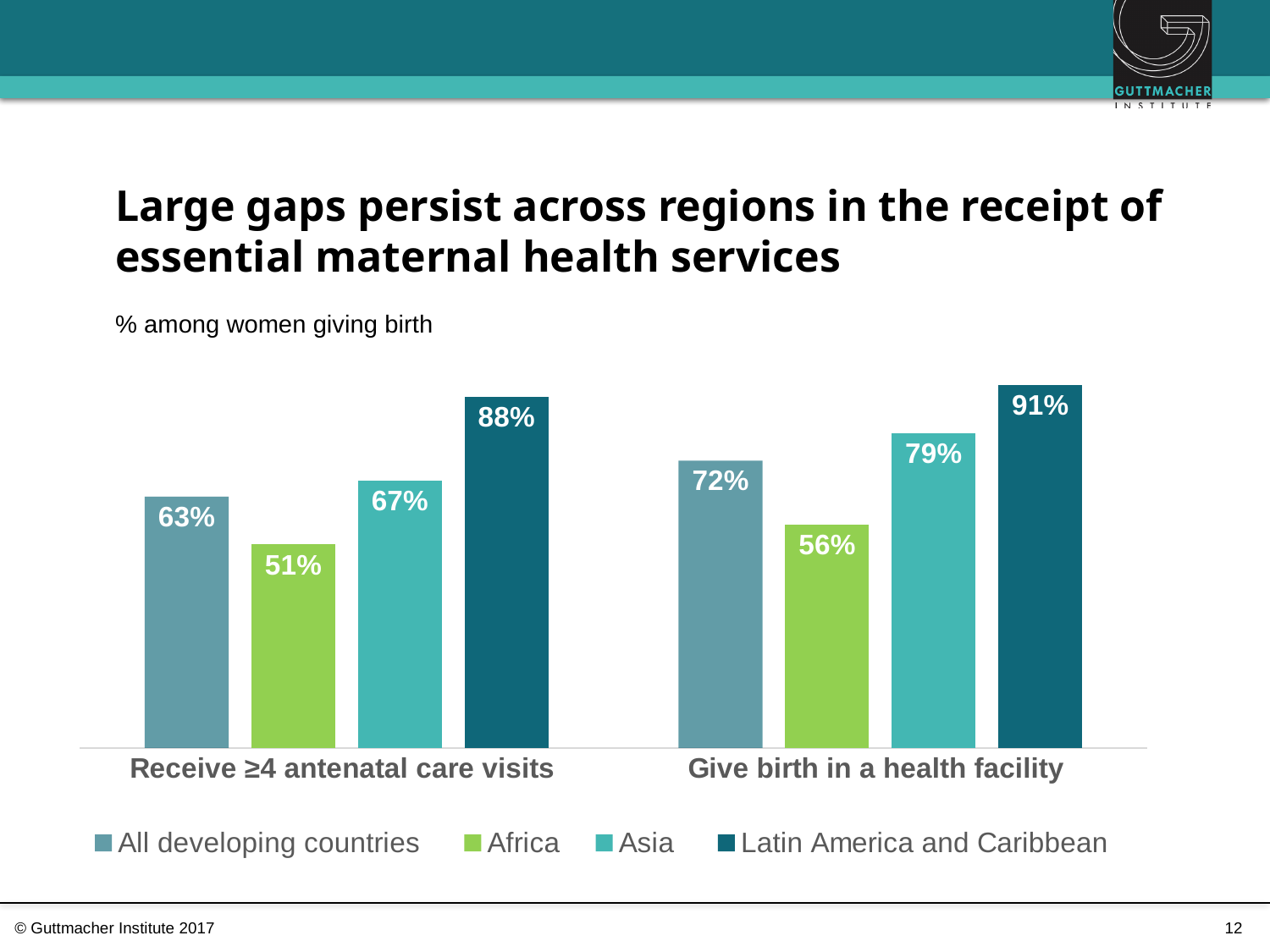
What percentage of women in Africa receive ≥4 antenatal care visits? 51% Which is larger: Asia's value for 'Receive ≥4 antenatal care visits' or Asia's value for 'Give birth in a health facility'? Give birth in a health facility Which region has the lowest value for 'Give birth in a health facility'? Africa What is the value for Asia for 'Give birth in a health facility'? 79% Which region has the highest value for 'Receive ≥4 antenatal care visits'? Latin America and Caribbean How many categories are shown on the x axis? 2 What is the value for All developing countries for 'Receive ≥4 antenatal care visits'? 63% What is the difference between Latin America and Caribbean and Africa for 'Receive ≥4 antenatal care visits'? 37 percentage points What is the difference between Asia and All developing countries for 'Give birth in a health facility'? 7 percentage points What percentage of women in Latin America and Caribbean give birth in a health facility? 91% How many series does the legend list? 4 What kind of chart is shown on the slide? Bar chart